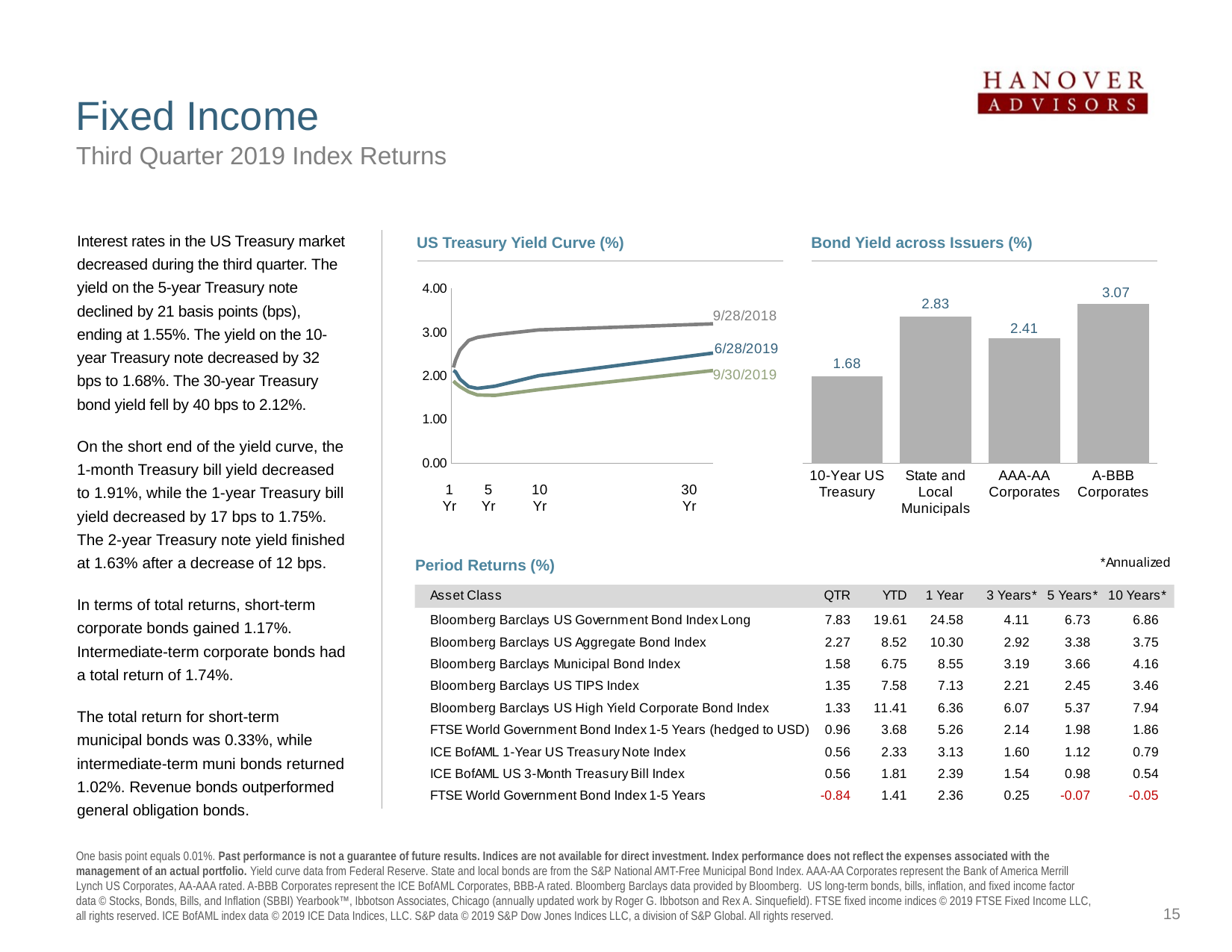
In the Bond Yield across Issuers (%) chart, what is the yield for State and Local Municipals? 2.83 How many issuer categories are shown in the Bond Yield across Issuers (%) chart? 4 What kind of chart is the US Treasury Yield Curve (%) chart? Line chart In the Bond Yield across Issuers (%) chart, what is the difference between the yields of A-BBB Corporates and AAA-AA Corporates? 0.66 In the Bond Yield across Issuers (%) chart, which issuer has the lowest yield? 10-Year US Treasury How many series are shown in the US Treasury Yield Curve (%) chart? 3 In the US Treasury Yield Curve (%) chart, which series lies highest across the curve? 9/28/2018 In the Bond Yield across Issuers (%) chart, which is larger: the yield for State and Local Municipals or for AAA-AA Corporates? State and Local Municipals In the Bond Yield across Issuers (%) chart, which issuer has the highest yield? A-BBB Corporates In the US Treasury Yield Curve (%) chart, is the 6/28/2019 value at 30 Yr greater or less than 2.00? greater What kind of chart is the Bond Yield across Issuers (%) chart? Bar chart In the Bond Yield across Issuers (%) chart, what is the yield for A-BBB Corporates? 3.07